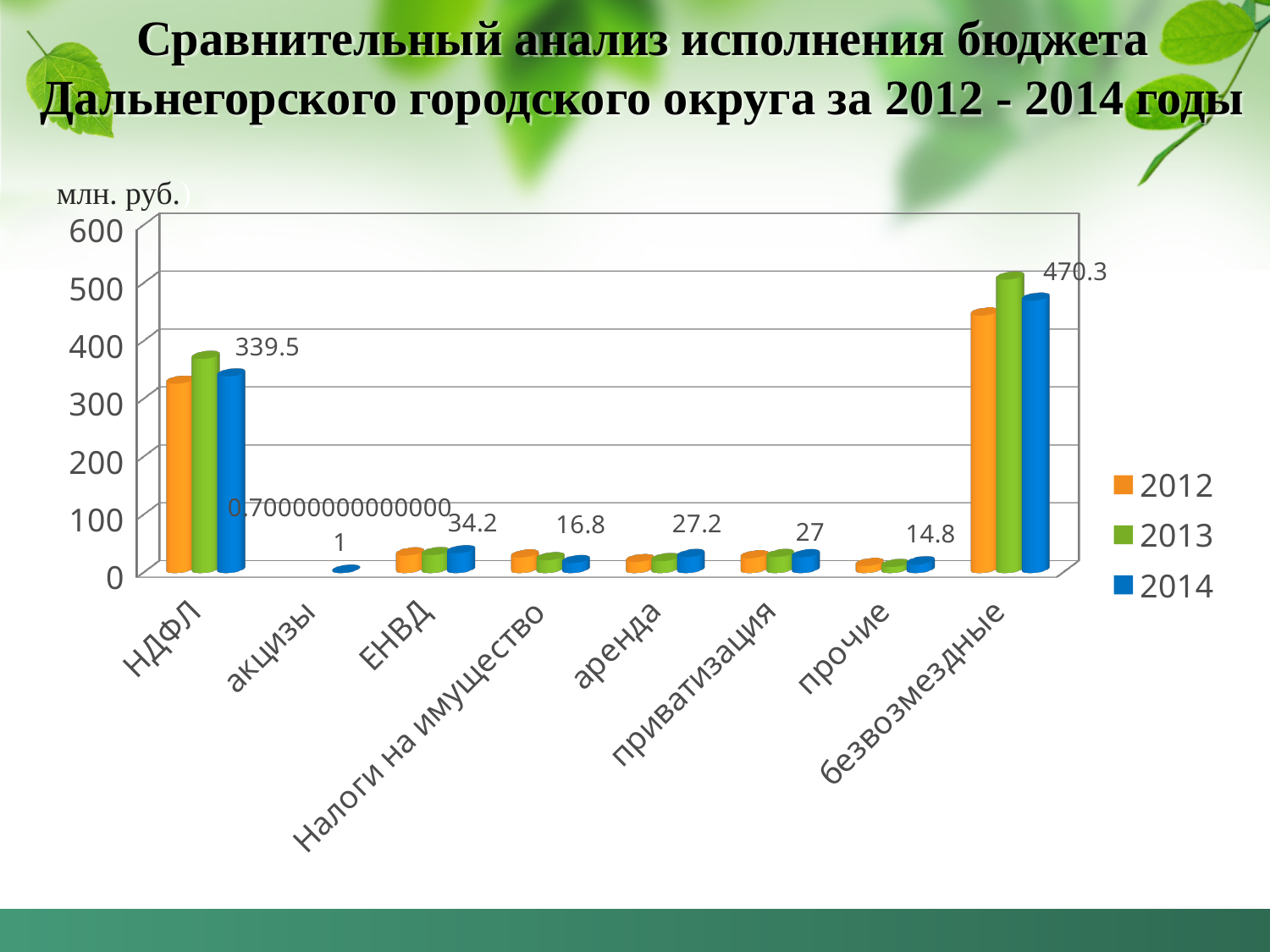
What is the 2014 value for НДФЛ? 339.5 How many series does the legend list? 3 What is the 2014 value for безвозмездные? 470.3 What is the 2014 value for ЕНВД? 34.2 How many categories are shown on the x axis? 8 Which category has the lowest 2014 value? акцизы What is the difference between the 2014 values for безвозмездные and НДФЛ? 130.8 What unit is shown above the vertical axis? млн. руб. Is the 2013 value for НДФЛ greater or less than 300? greater Which category has the highest 2014 value? безвозмездные What is the 2014 value for прочие? 14.8 What kind of chart is shown on the slide? bar chart